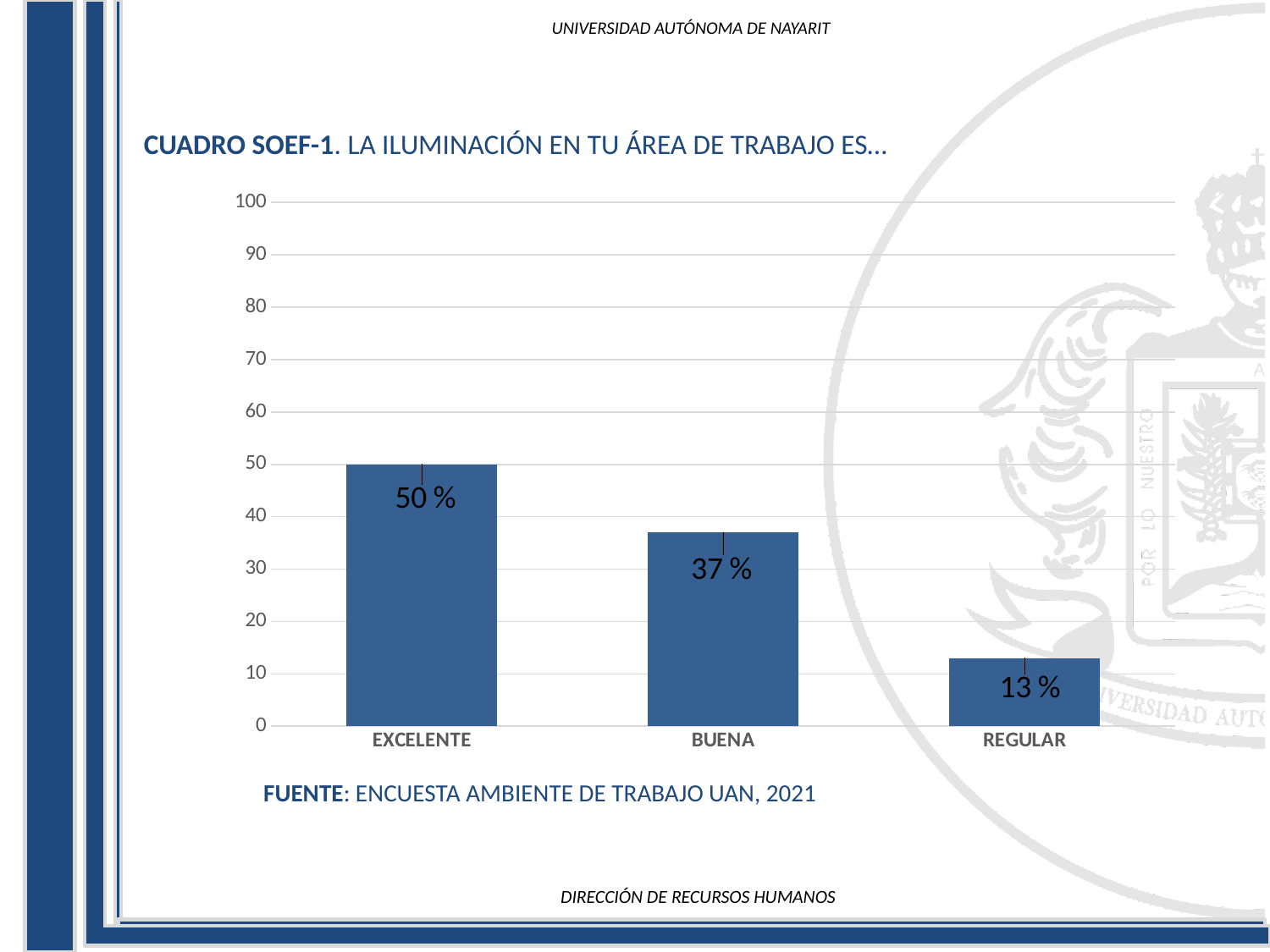
Do the values rise or fall from EXCELENTE to REGULAR along the x axis? fall Which category has the lowest value? REGULAR What is the value for REGULAR? 13 % Which is larger, the value for BUENA or the value for REGULAR? BUENA How many categories are shown on the x axis? 3 Is the value for BUENA greater or less than 40? less What is the value for BUENA? 37 % Which category has the highest value? EXCELENTE What is the difference between the values for BUENA and REGULAR? 24 % What kind of chart is shown on the slide? bar chart What is the difference between the values for EXCELENTE and BUENA? 13 % What is the value for EXCELENTE? 50 %